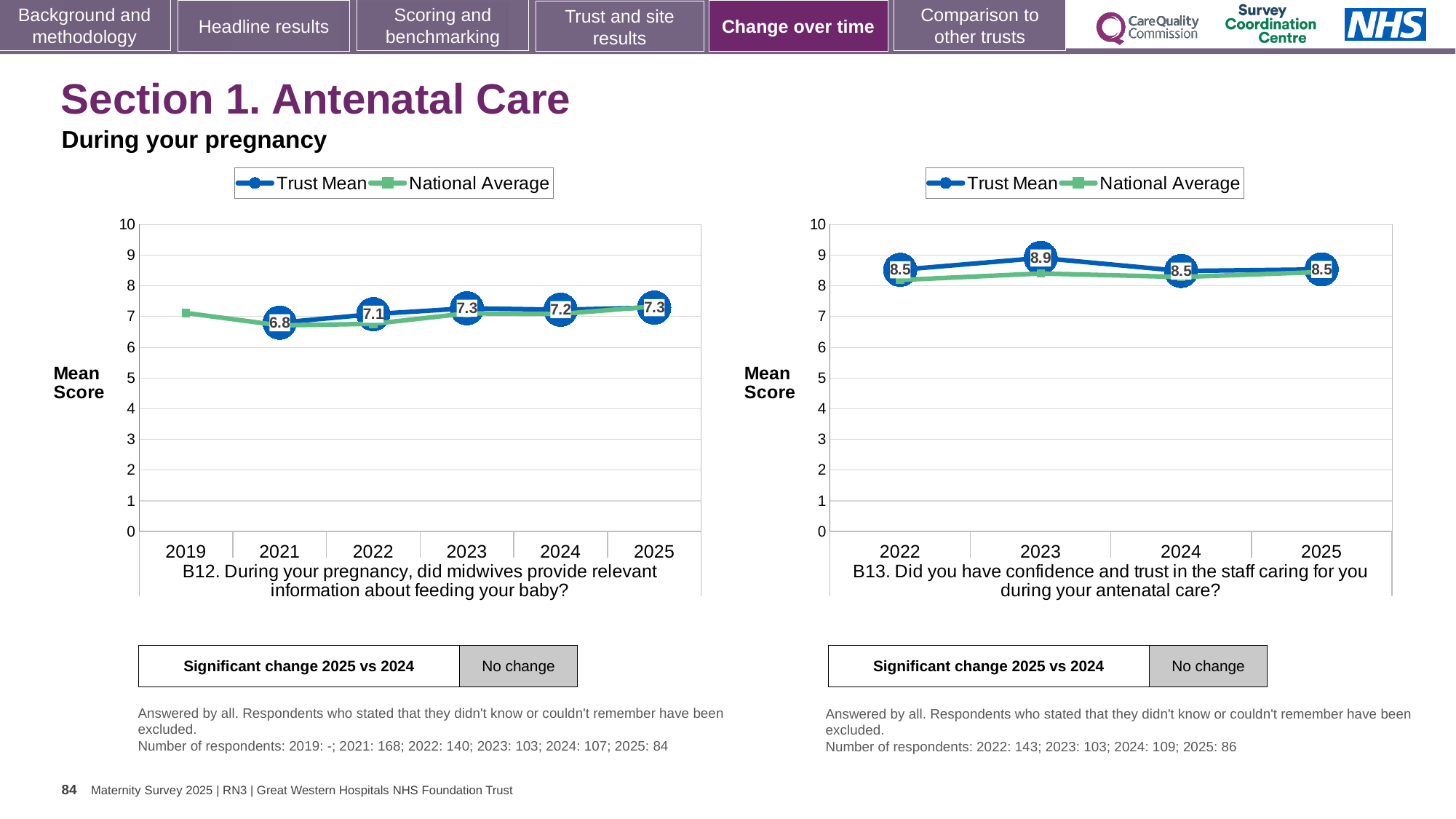
In the B12 chart on the left, which year has the lowest Trust Mean? 2021 In the B13 chart on the right, does the Trust Mean rise or fall from 2023 to 2024? Fall In the B13 chart on the right, what is the difference between the Trust Mean for 2023 and the Trust Mean for 2024? 0.4 In the B12 chart on the left, what is the Trust Mean for 2021? 6.8 How many series does the legend of the B13 chart on the right list? 2 What kind of chart is the B13 chart on the right? Line chart How many years are shown on the x axis of the B12 chart on the left? 6 In the B13 chart on the right, what is the Trust Mean for 2023? 8.9 In the B12 chart on the left, what is the Trust Mean for 2025? 7.3 In the B12 chart on the left, is the Trust Mean higher in 2021 or in 2023? 2023 In the B12 chart on the left, is the National Average for 2019 greater or less than 5? greater In the B13 chart on the right, which year has the highest Trust Mean? 2023